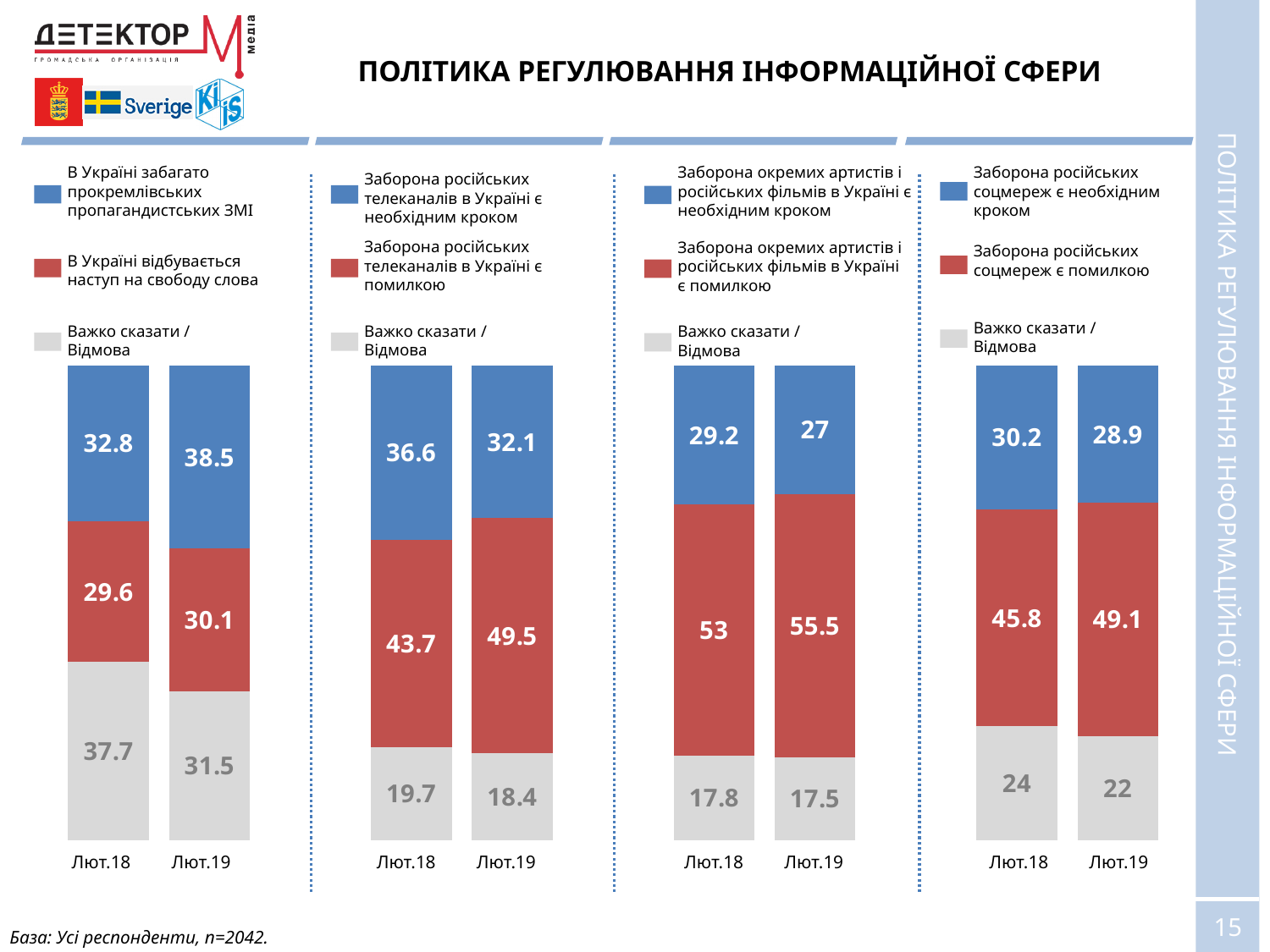
How many bars are shown in the third chart from the left? 2 In the rightmost chart, what is the value for 'Заборона російських соцмереж є помилкою' in Лют.19? 49.1 In the third chart from the left, what is the value for 'Заборона окремих артистів і російських фільмів в Україні є необхідним кроком' in Лют.18? 29.2 What kind of chart is the leftmost chart? stacked bar chart In the rightmost chart, does the value for 'Важко сказати / Відмова' rise or fall from Лют.18 to Лют.19? fall In the third chart from the left, which is larger in Лют.19: 'є необхідним кроком' or 'є помилкою'? є помилкою In the leftmost chart, what is the value for 'В Україні забагато прокремлівських пропагандистських ЗМІ' in Лют.19? 38.5 In the second chart from the left, what is the value for 'Заборона російських телеканалів в Україні є помилкою' in Лют.19? 49.5 In the rightmost chart, what is the total of the Лют.18 stacked bar? 100 How many series does the legend of the second chart from the left list? 3 In the second chart from the left, by how much did 'Заборона російських телеканалів в Україні є помилкою' change from Лют.18 to Лют.19? 5.8 In the leftmost chart, what is the value for 'Важко сказати / Відмова' in Лют.18? 37.7